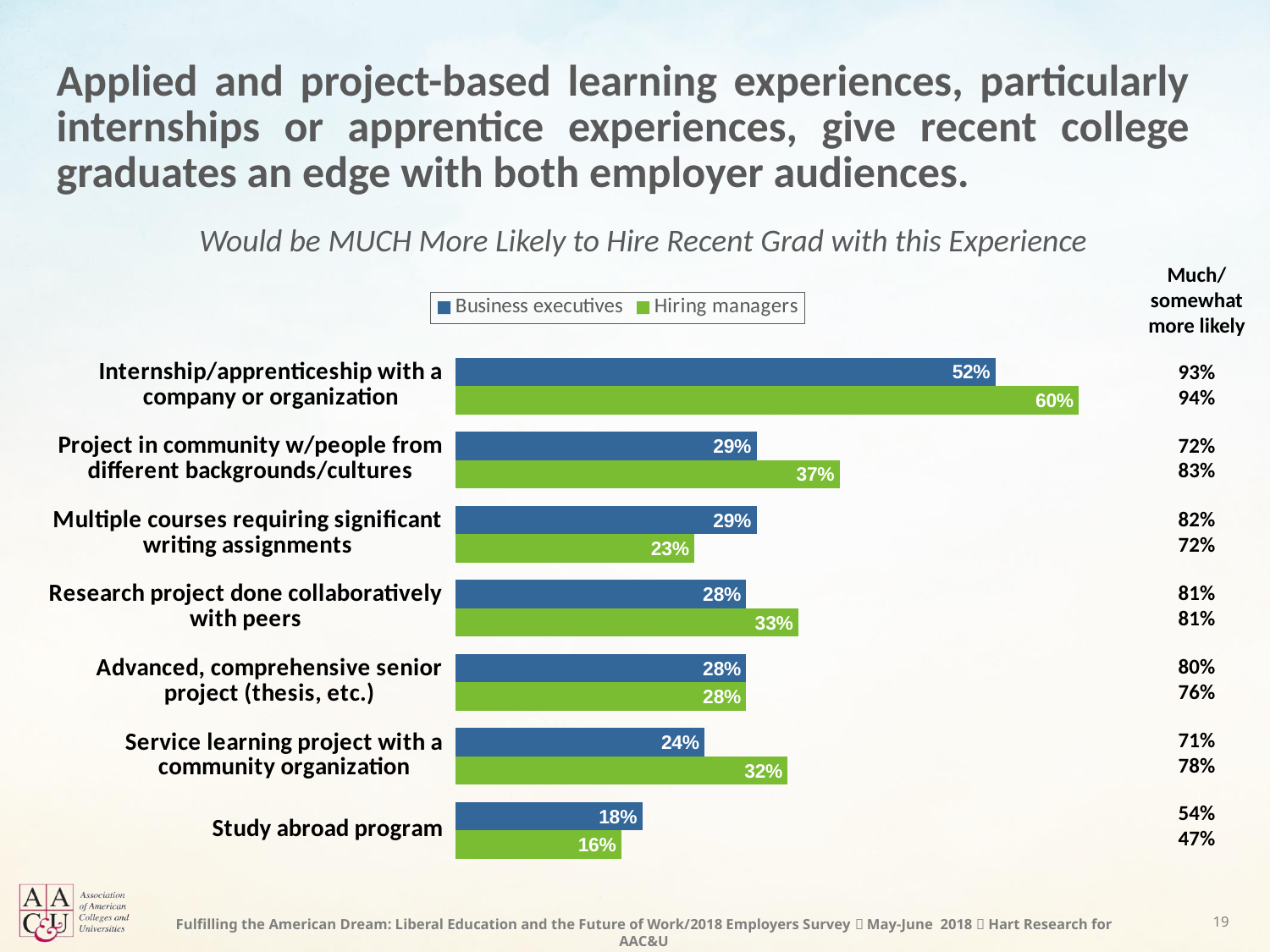
What is the chart's title? Would be MUCH More Likely to Hire Recent Grad with this Experience For 'Multiple courses requiring significant writing assignments', which series has the larger value: Business executives or Hiring managers? Business executives How many experience categories are shown in the chart? 7 Which experience has the lowest Hiring managers value? Study abroad program Which colour represents Hiring managers in the chart? Green What is the difference between the Hiring managers and Business executives values for 'Service learning project with a community organization'? 8% How many series does the legend list? 2 What type of chart is shown on the slide? Bar chart Which experience has the highest Business executives value? Internship/apprenticeship with a company or organization What is the Hiring managers value for 'Project in community w/people from different backgrounds/cultures'? 37% What percentage of hiring managers would be much more likely to hire a recent grad with an internship/apprenticeship with a company or organization? 60% What is the Business executives value for 'Study abroad program'? 18%